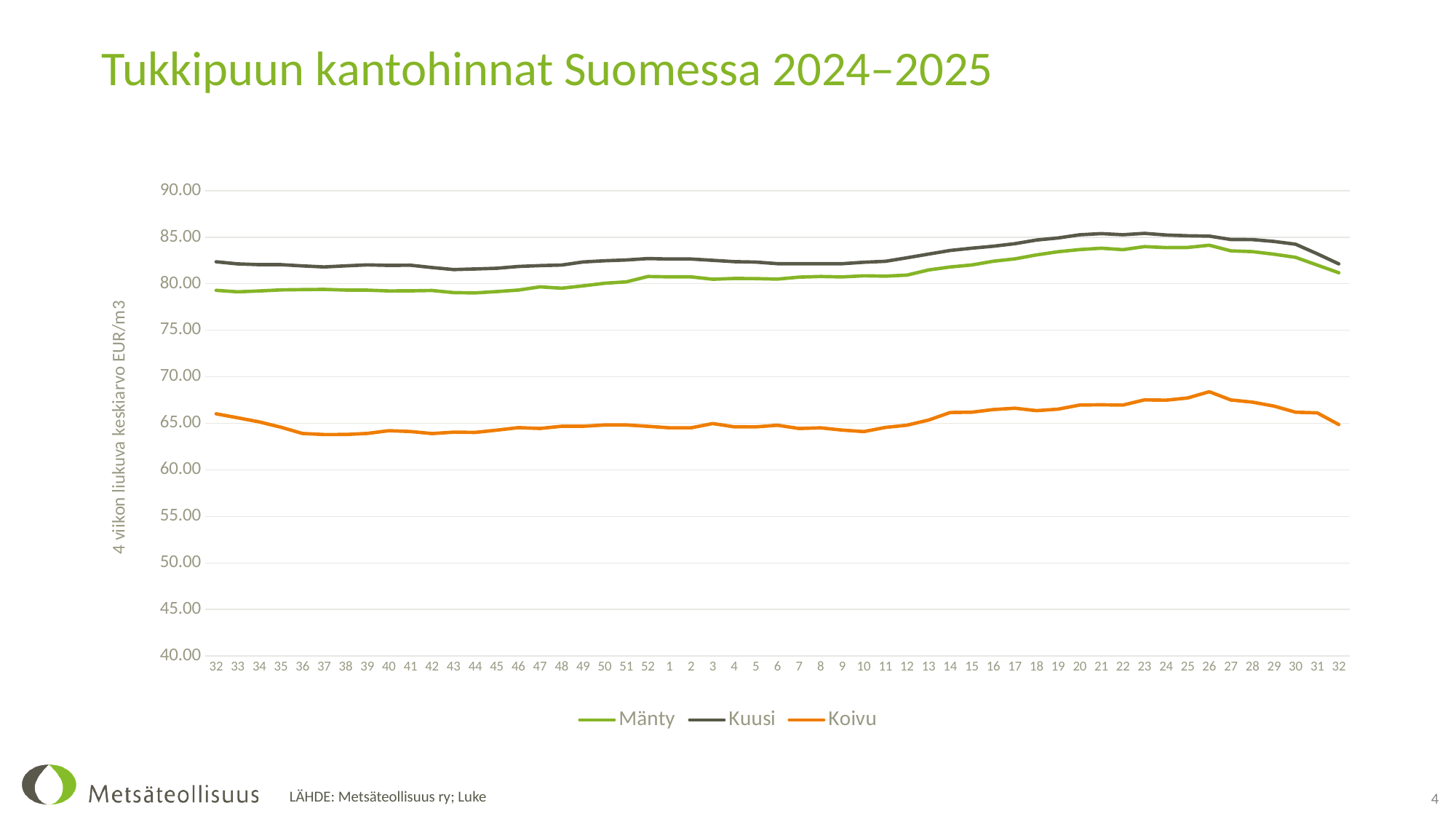
Is the value for Mänty at week 44 greater or less than 80.00? less At week 1, which is larger: the value for Kuusi or the value for Mänty? Kuusi Is the value for Kuusi at week 36 greater or less than 85.00? less Which series has the lowest values throughout the chart? Koivu Does the Koivu line rise or fall between week 26 and week 32 at the right end of the chart? fall What is the title of the chart? Tukkipuun kantohinnat Suomessa 2024–2025 How many series does the legend list? 3 What kind of chart is shown on the slide? line chart Does the Mänty line rise or fall between week 12 and week 26? rise Is the value for Koivu at week 14 greater or less than 65.00? greater Which series has the highest values throughout the chart? Kuusi